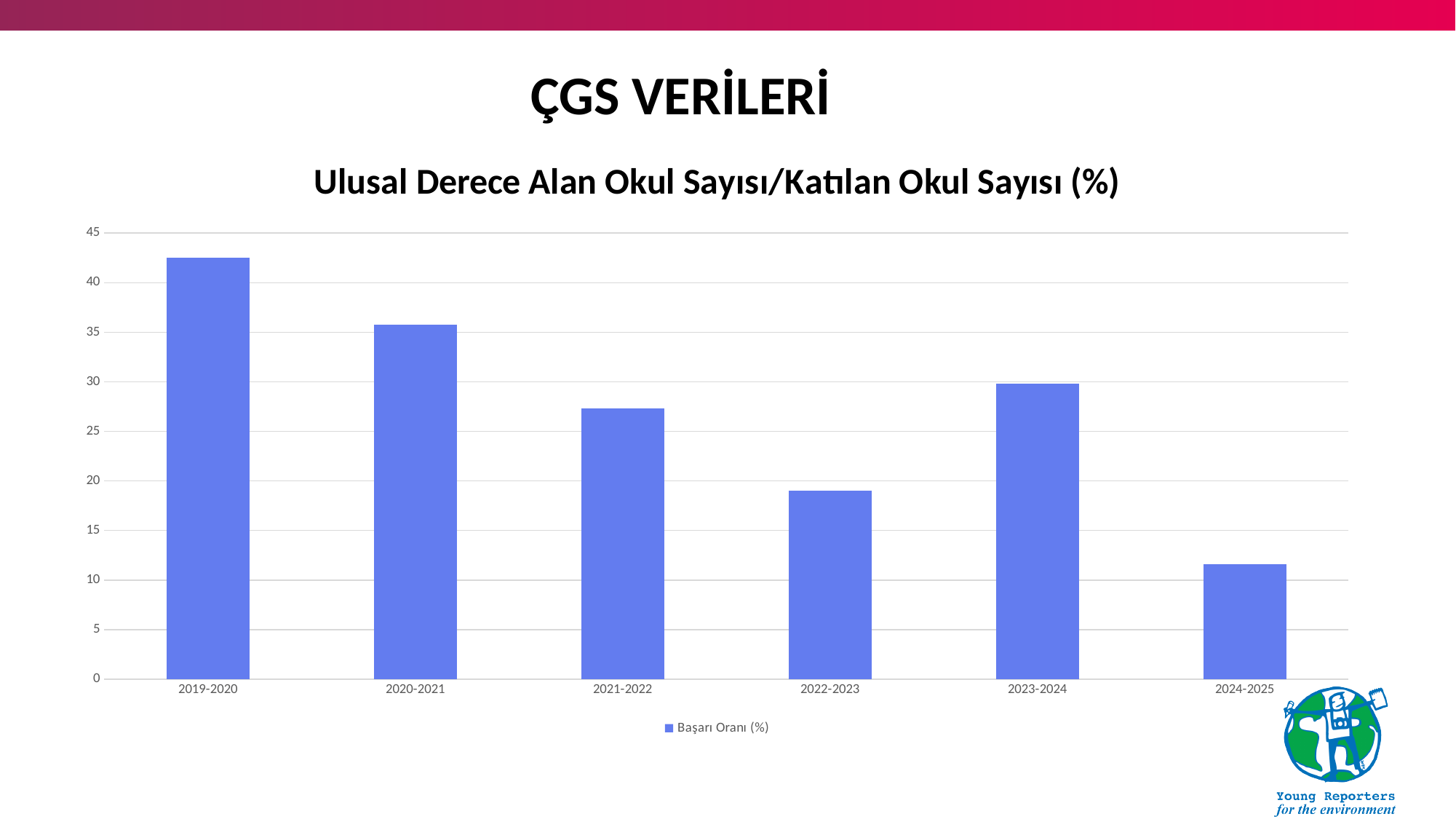
Is the value for 2019-2020 greater or less than 40? greater What is the name of the series shown in the chart's legend? Başarı Oranı (%) Which has a larger value, 2020-2021 or 2022-2023? 2020-2021 Which has a larger value, 2021-2022 or 2023-2024? 2023-2024 Which academic year has the highest value in the chart? 2019-2020 What kind of chart is shown on the slide? bar chart Is the value for 2024-2025 greater or less than 10? greater Which academic year has the lowest value in the chart? 2024-2025 Is the value for 2022-2023 greater or less than 20? less How many academic years are shown on the x axis of the chart? 6 How many series does the chart's legend list? 1 What is the title of the chart? Ulusal Derece Alan Okul Sayısı/Katılan Okul Sayısı (%)